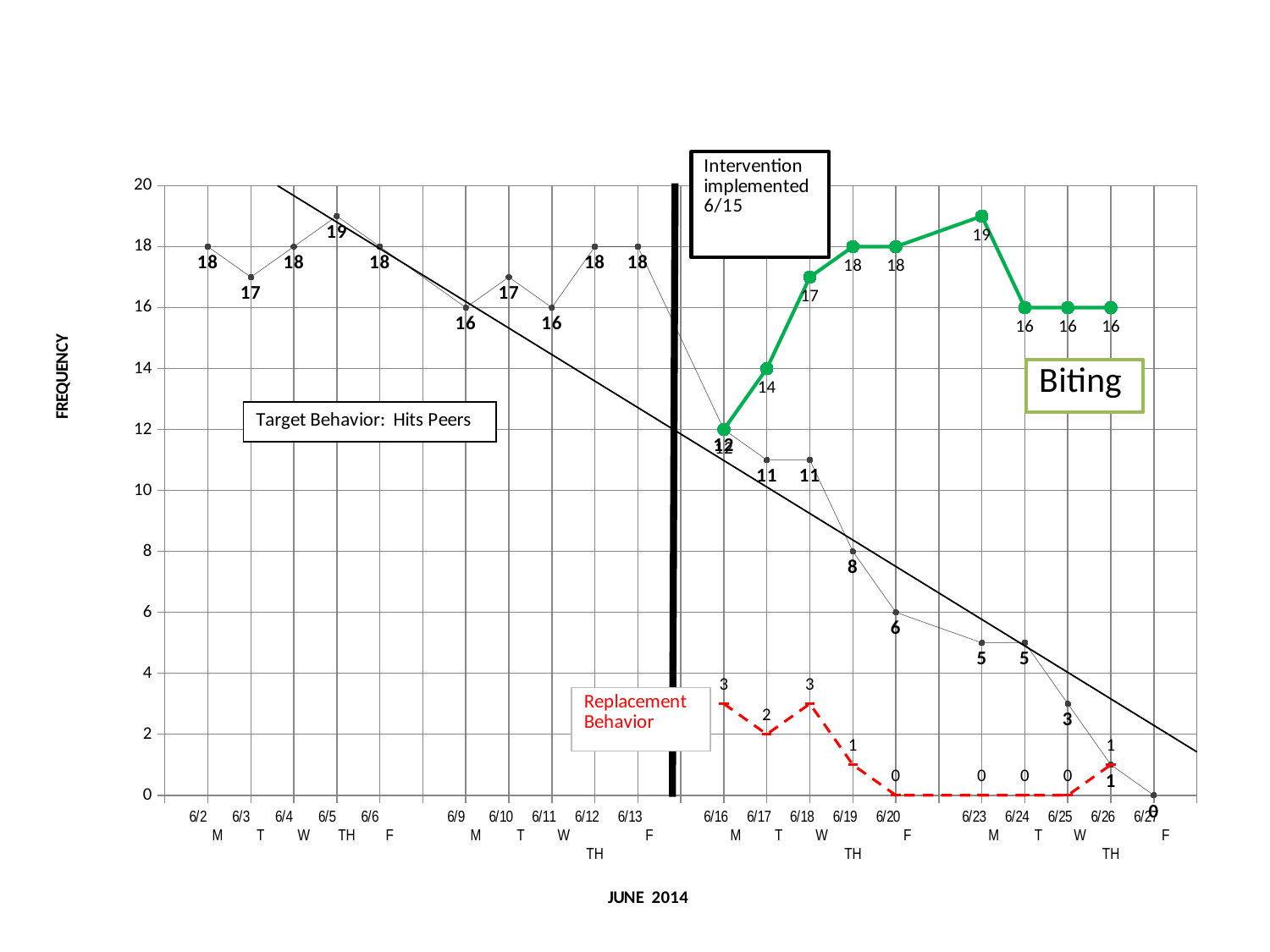
On 6/19, which is higher: the Biting frequency or the Hits Peers frequency? Biting On which date does the target behavior (Hits Peers) reach its lowest value? 6/27 How many data points are plotted for the Biting series? 9 On what date was the intervention implemented, according to the annotation on the chart? 6/15 What kind of chart is shown on the slide? line chart After the intervention on 6/15, does the Hits Peers frequency rise or fall over the following dates? fall What is the difference between the Hits Peers frequency on 6/16 and on 6/20? 6 What is the Replacement Behavior frequency on 6/17? 2 On which date does the Biting series reach its highest value? 6/23 What is the frequency of Hits Peers on 6/5? 19 What is the frequency of the target behavior (Hits Peers) on 6/19? 8 What is the Biting frequency on 6/23? 19